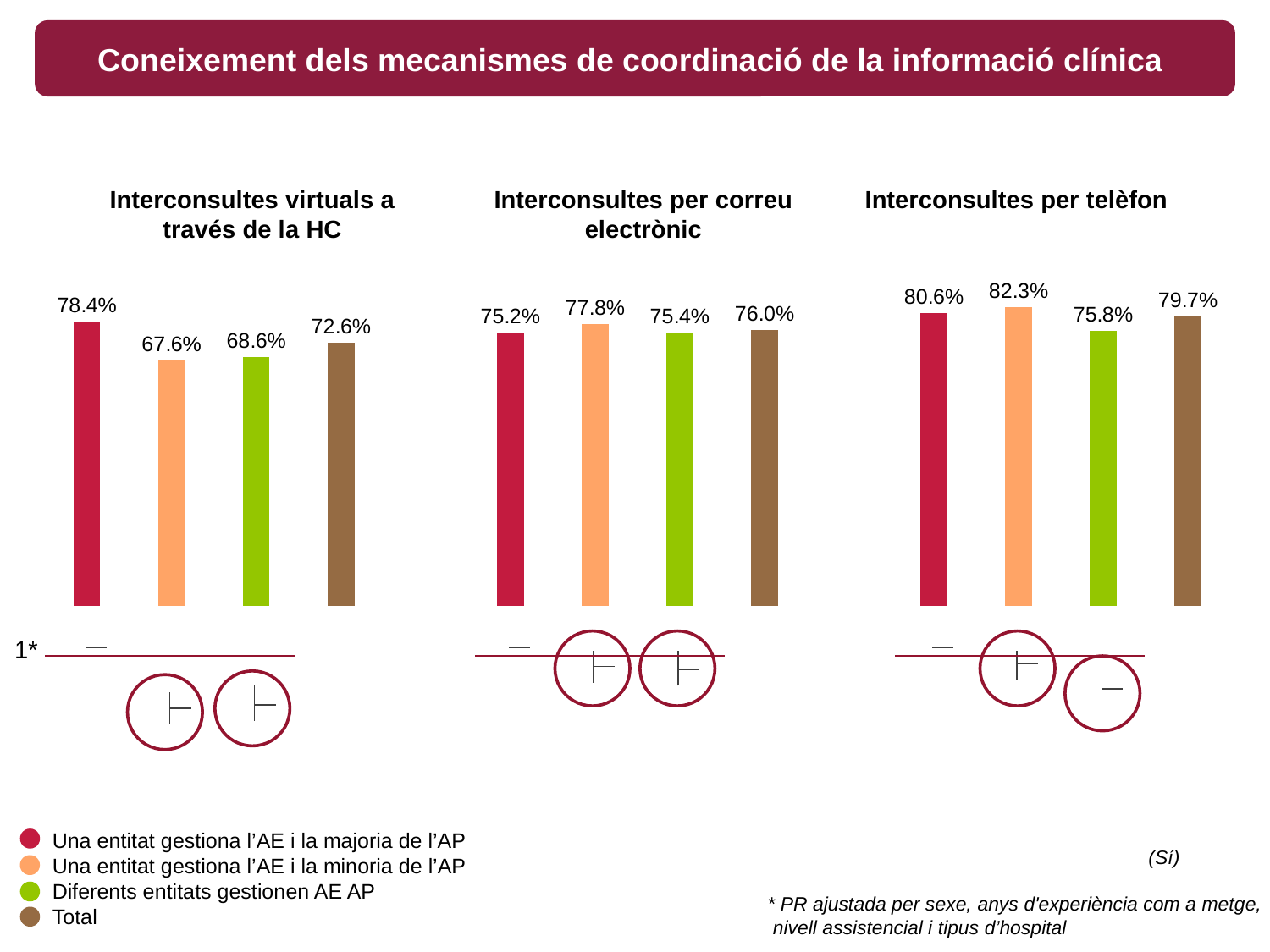
In the 'Interconsultes per telèfon' chart, what is the value for 'Diferents entitats gestionen AE AP'? 75.8% What type of chart is 'Interconsultes per correu electrònic'? Bar chart In the 'Interconsultes per telèfon' chart, which category has the highest value? Una entitat gestiona l'AE i la minoria de l'AP Which legend entry is shown in brown? Total In the 'Interconsultes virtuals a través de la HC' chart, what is the value for 'Una entitat gestiona l'AE i la majoria de l'AP'? 78.4% How many bars are shown in the 'Interconsultes per telèfon' chart? 4 In the 'Interconsultes virtuals a través de la HC' chart, what is the difference between the values for 'Una entitat gestiona l'AE i la majoria de l'AP' and 'Total'? 5.8% In the 'Interconsultes per correu electrònic' chart, what is the value for 'Total'? 76.0% In the 'Interconsultes per correu electrònic' chart, which is larger: the value for 'Una entitat gestiona l'AE i la minoria de l'AP' or the value for 'Total'? Una entitat gestiona l'AE i la minoria de l'AP In the 'Interconsultes per telèfon' chart, what is the difference between the values for 'Una entitat gestiona l'AE i la minoria de l'AP' and 'Diferents entitats gestionen AE AP'? 6.5% How many entries does the legend at the bottom of the slide list? 4 In the 'Interconsultes virtuals a través de la HC' chart, which category has the lowest value? Una entitat gestiona l'AE i la minoria de l'AP